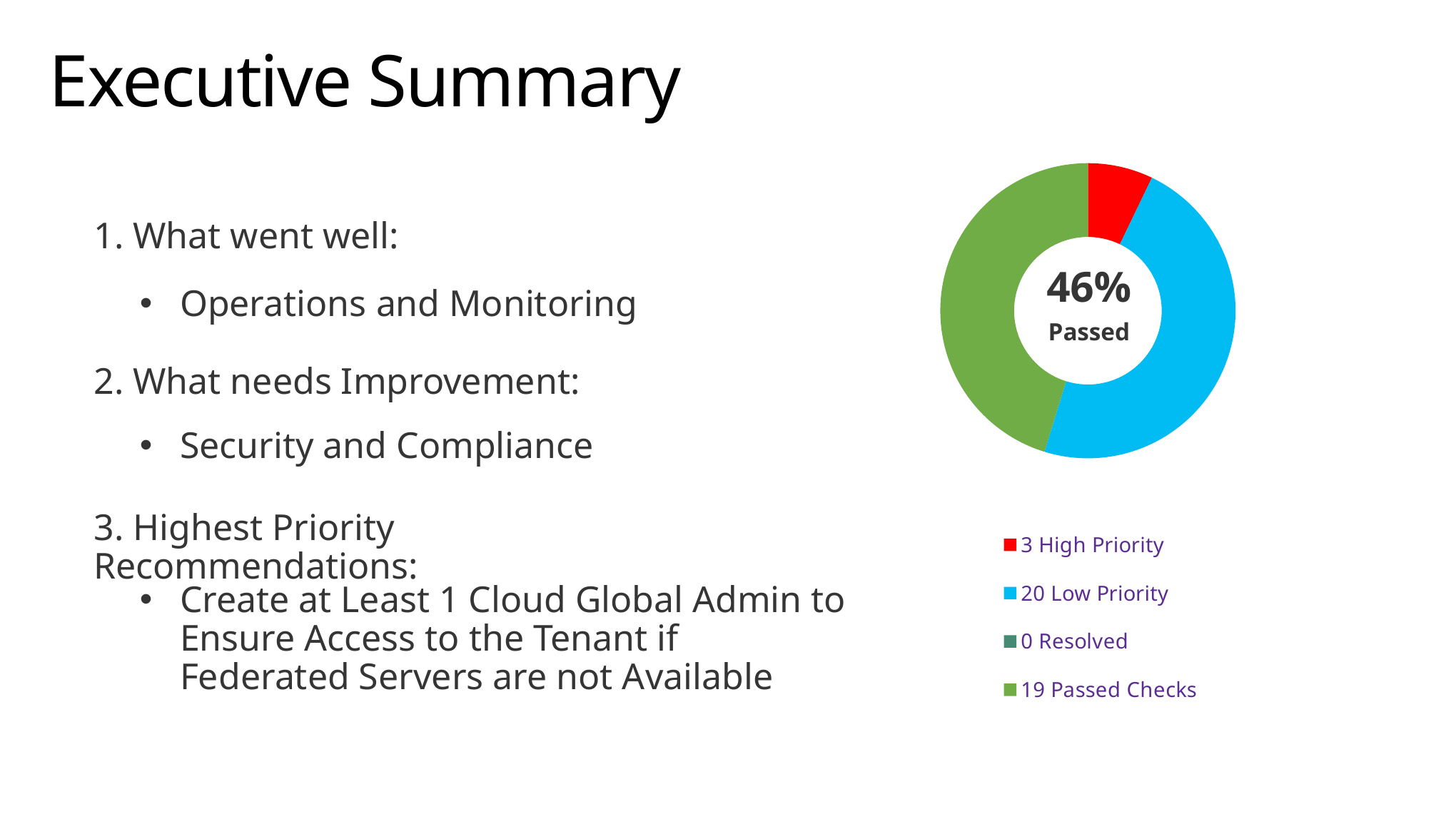
How many checks are Low Priority according to the chart legend? 20 What kind of chart is shown on the slide? Donut chart What colour represents High Priority in the chart? Red How many checks are Resolved according to the chart legend? 0 Which is larger, the number of Low Priority checks or the number of Passed Checks? Low Priority What percentage is shown in the centre of the donut chart as Passed? 46% Which category has the smallest count in the chart? Resolved Which category has the largest count in the chart? Low Priority How many Passed Checks are there according to the chart legend? 19 How many checks are High Priority according to the chart legend? 3 What is the difference between the number of Low Priority checks and the number of High Priority checks? 17 How many categories does the chart's legend list? 4